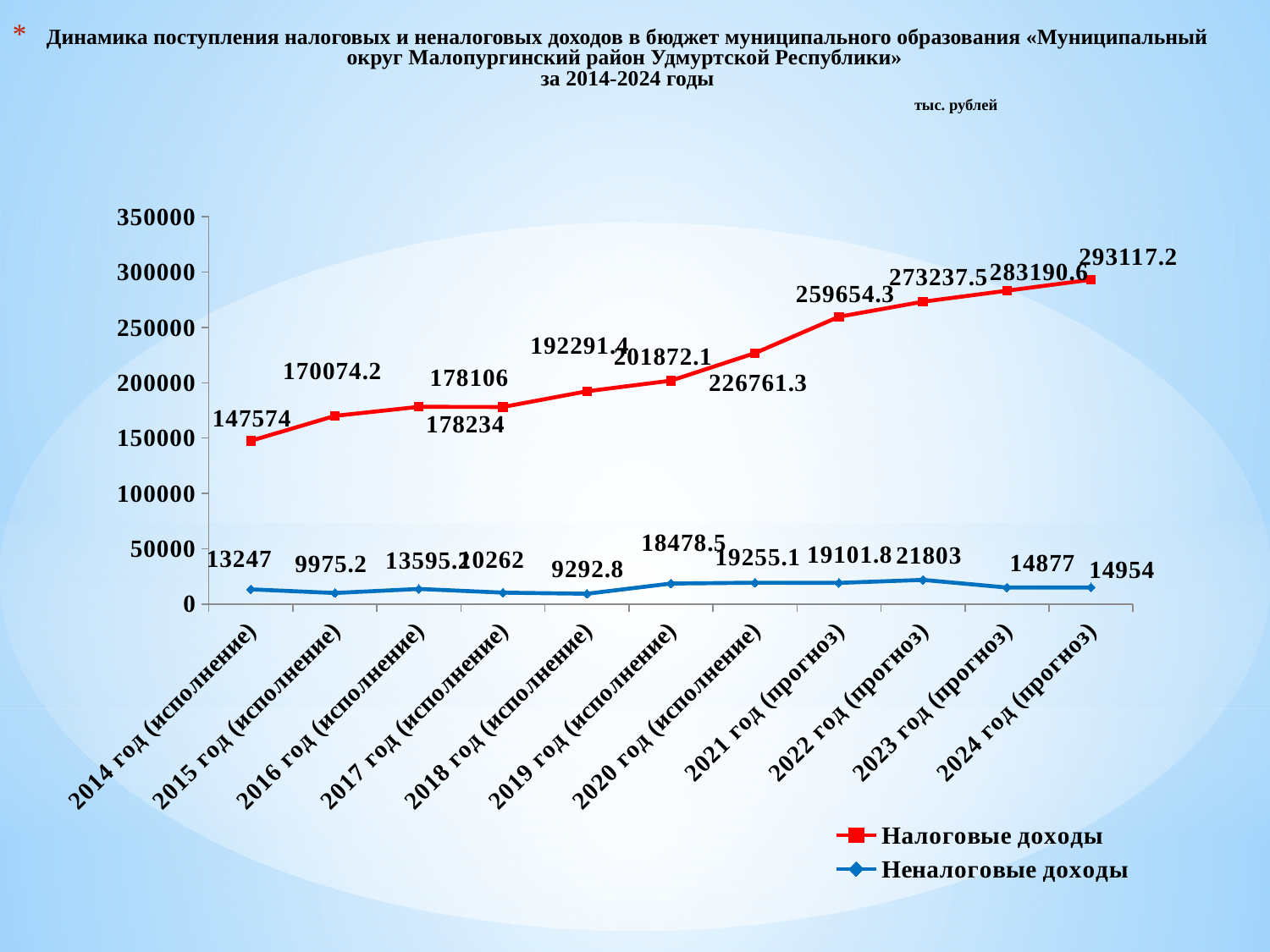
How many years are shown on the x axis of the chart? 11 In which year is the value of Неналоговые доходы the highest? 2022 год (прогноз) In which year is the value of Неналоговые доходы the lowest? 2018 год (исполнение) What is the value of Неналоговые доходы for 2022 год (прогноз)? 21803 By how much does Налоговые доходы in 2024 год (прогноз) exceed Налоговые доходы in 2014 год (исполнение)? 145543.2 What is the value of Налоговые доходы for 2024 год (прогноз)? 293117.2 How many series does the legend list? 2 Is the value of Налоговые доходы for 2020 год (исполнение) greater or less than 200000? greater Which year has the larger value of Налоговые доходы: 2020 год (исполнение) or 2021 год (прогноз)? 2021 год (прогноз) What is the value of Налоговые доходы for 2014 год (исполнение)? 147574 What kind of chart is shown on the slide? line chart What is the difference between Неналоговые доходы in 2024 год (прогноз) and 2023 год (прогноз)? 77